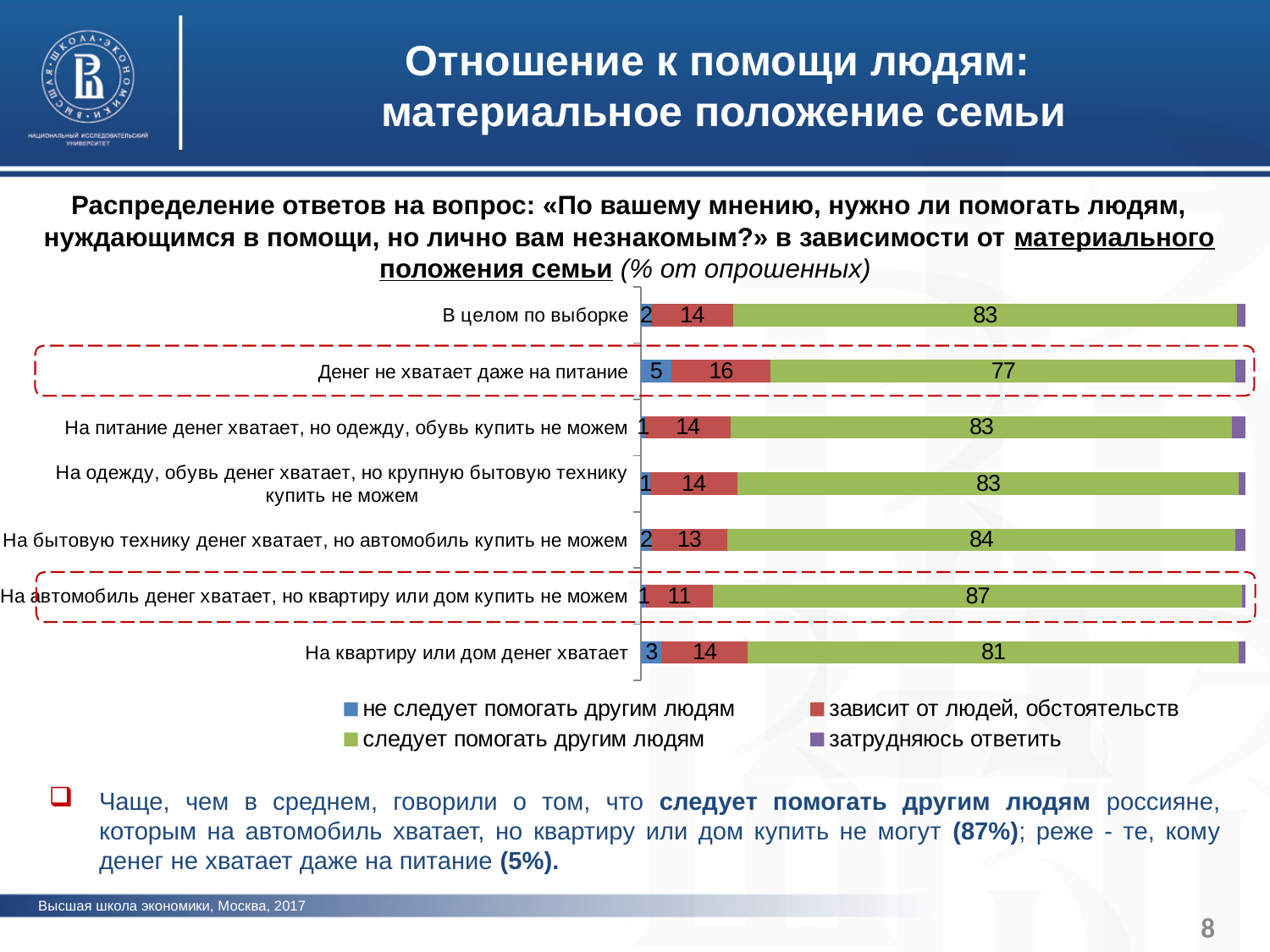
Which category has the lowest value for «следует помогать другим людям»? Денег не хватает даже на питание Which category has the highest value for «не следует помогать другим людям»? Денег не хватает даже на питание What is the value of «не следует помогать другим людям» for the category «На квартиру или дом денег хватает»? 3 How many categories (rows) are plotted in the chart? 7 Which is larger: the «зависит от людей, обстоятельств» value for «Денег не хватает даже на питание» or for «На бытовую технику денег хватает, но автомобиль купить не можем»? Денег не хватает даже на питание Which category has the highest value for «следует помогать другим людям»? На автомобиль денег хватает, но квартиру или дом купить не можем How many series does the legend list? 4 What type of chart is shown on the slide? stacked bar chart Which legend entry is shown in green? следует помогать другим людям What is the value of «следует помогать другим людям» for the category «Денег не хватает даже на питание»? 77 What is the value of «зависит от людей, обстоятельств» for the category «На автомобиль денег хватает, но квартиру или дом купить не можем»? 11 What is the difference between the «следует помогать другим людям» values for «На автомобиль денег хватает, но квартиру или дом купить не можем» and «Денег не хватает даже на питание»? 10